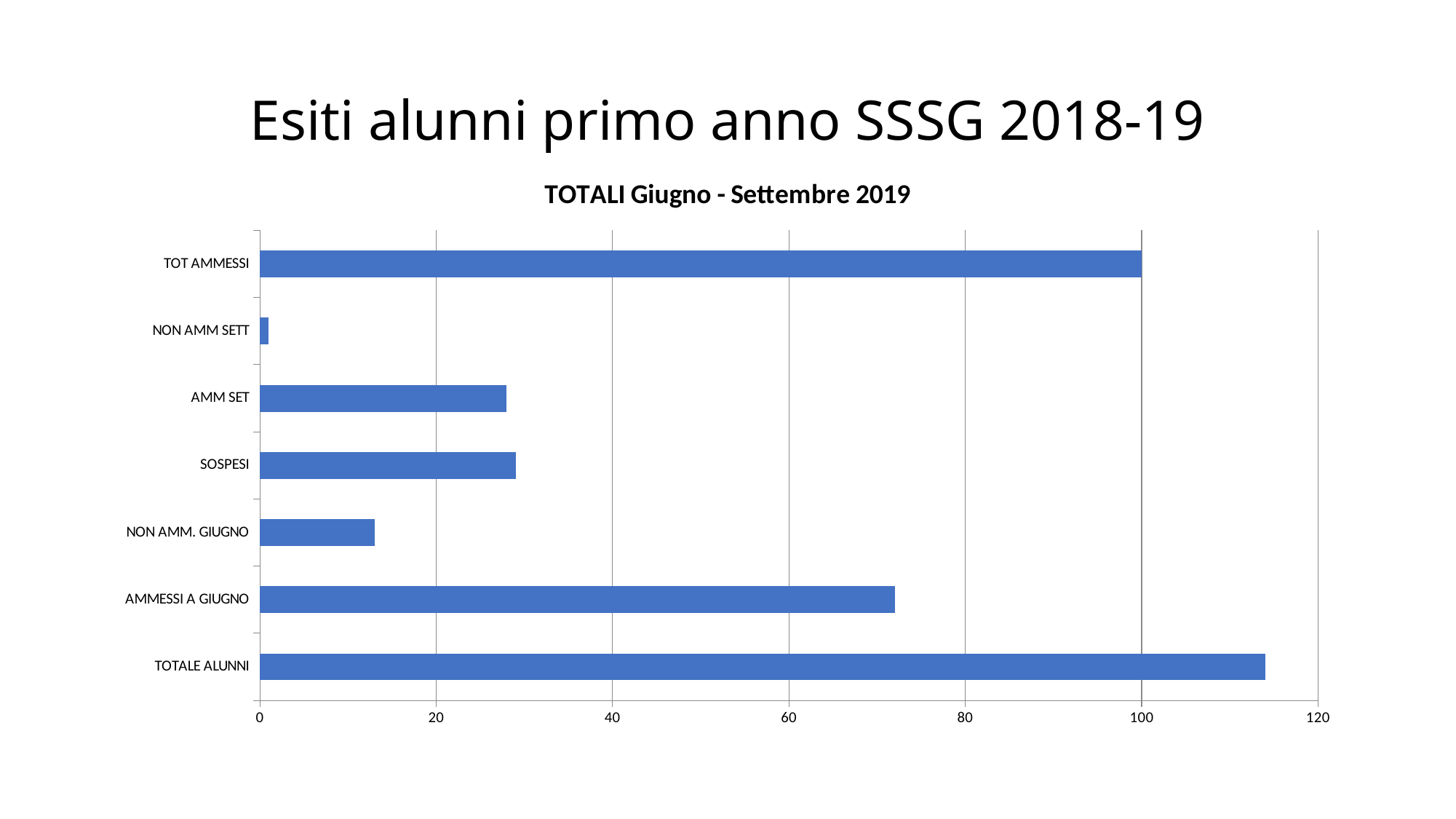
Is the value for AMMESSI A GIUGNO greater or less than 60? greater Is the value for SOSPESI greater or less than 20? greater Which category has the highest value? TOTALE ALUNNI What is the value for TOT AMMESSI? 100 Is the value for AMM SET greater or less than 40? less How many categories are plotted in the chart? 7 Which is larger, the value for TOT AMMESSI or the value for AMMESSI A GIUGNO? TOT AMMESSI Which category has the lowest value? NON AMM SETT What is the title of the chart? TOTALI Giugno - Settembre 2019 What kind of chart is shown on the slide? bar chart